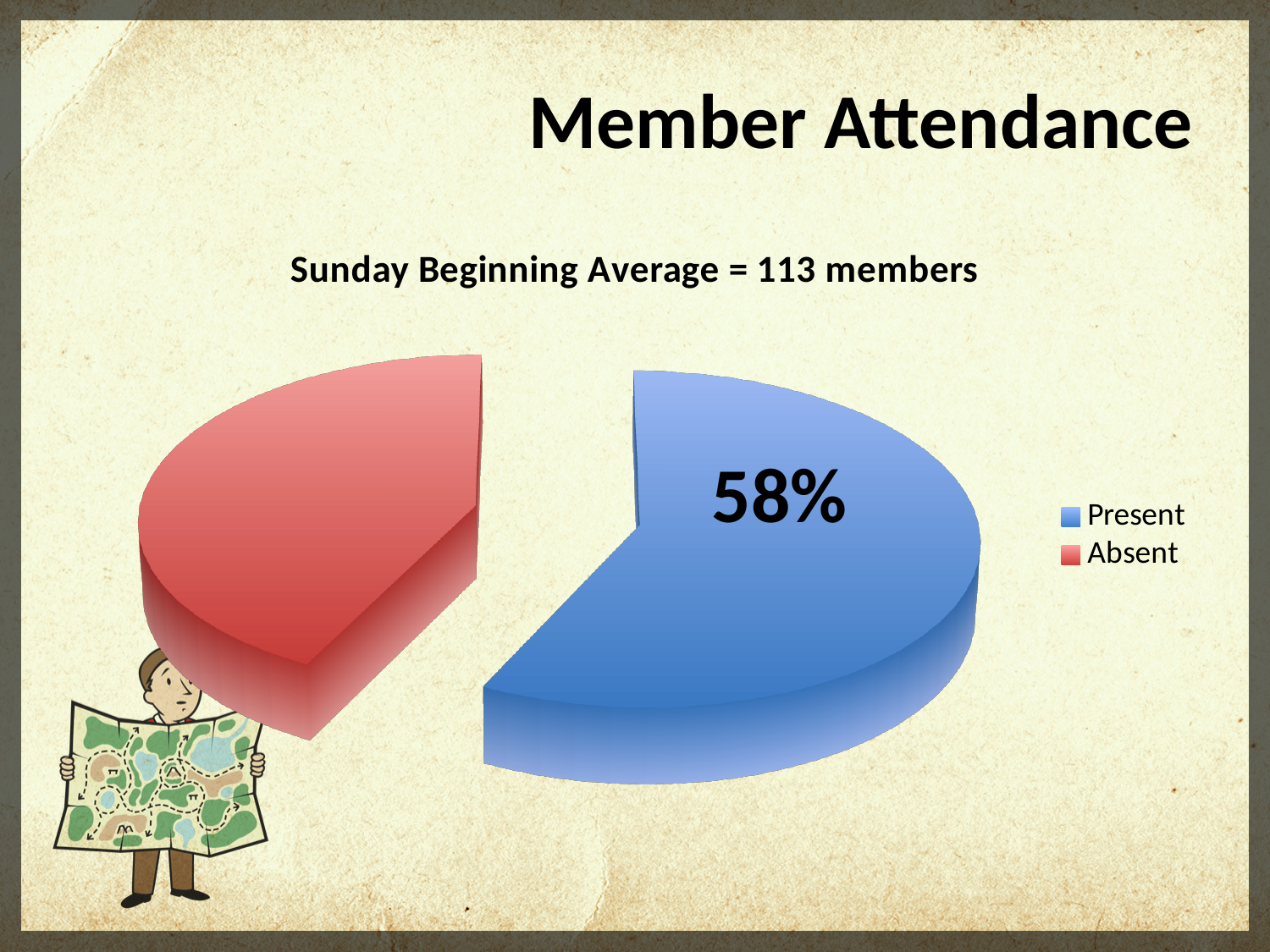
Which category has the largest slice in the pie chart? Present What is the title of the slide containing the chart? Member Attendance How many slices does the pie chart have? 2 Which slice is larger, Present or Absent? Present What is the Sunday Beginning Average number of members stated above the chart? 113 members How many entries does the legend list? 2 What percentage of members are shown as Present in the pie chart? 58% Which category has the smallest slice in the pie chart? Absent What kind of chart is shown on the slide? Pie chart Which colour represents Absent in the pie chart? Red